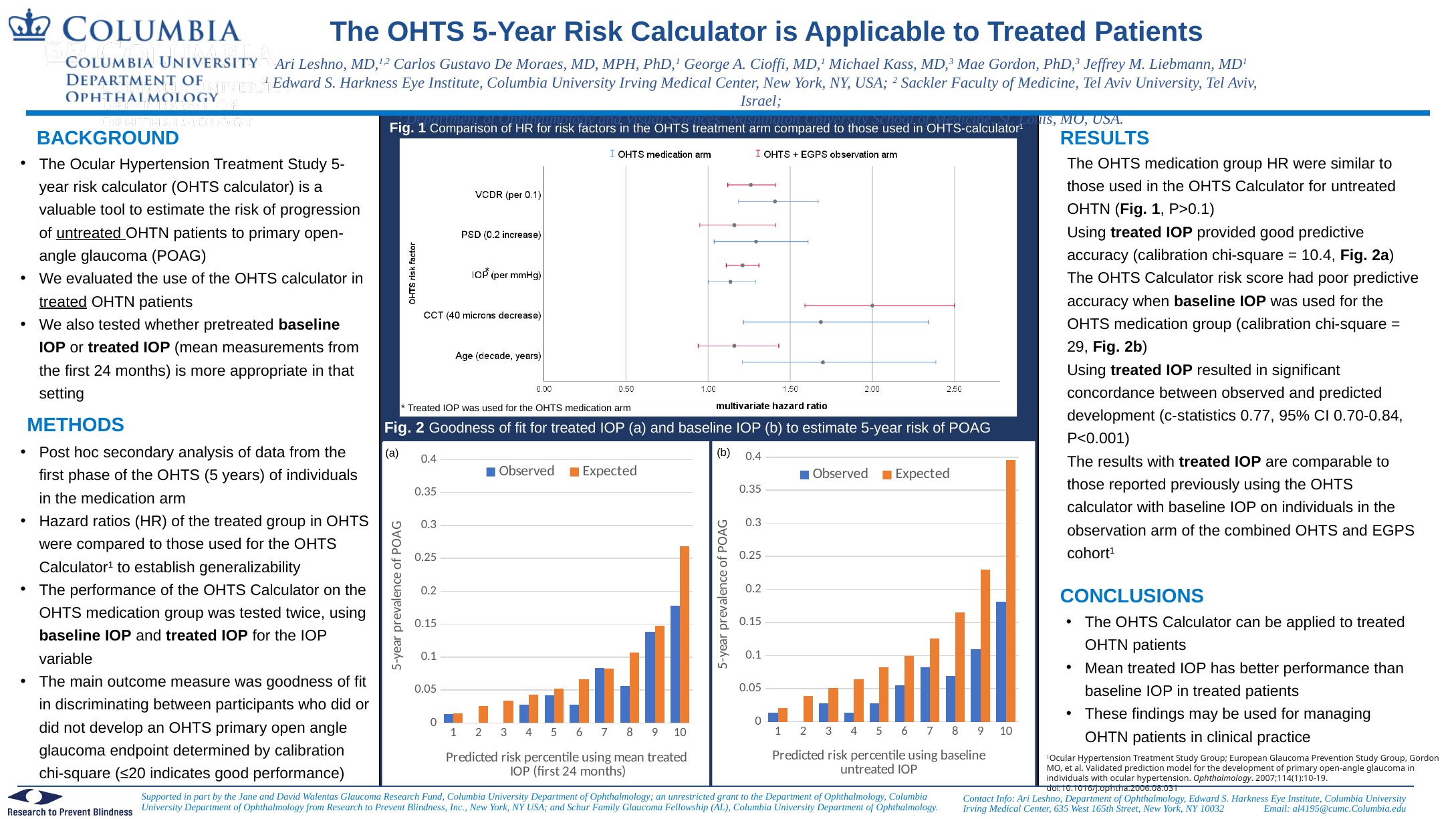
In Fig. 2a, is the Observed value for percentile 10 greater or less than 0.2? less In Fig. 2a, do the Expected values rise or fall as the predicted risk percentile increases from 1 to 10? rise In Fig. 2b, at percentile 10, which is larger, the Observed or the Expected value? Expected In Fig. 2a, how many series does the legend list? 2 In Fig. 1, how many series does the legend list? 2 In Fig. 1, what is the label of the x axis? multivariate hazard ratio In Fig. 2b, is the Expected value for percentile 10 greater or less than 0.35? greater In Fig. 2b, is the Expected value for percentile 9 greater or less than 0.2? greater In Fig. 2b, which predicted risk percentile has the lowest Observed 5-year prevalence of POAG? 2 In Fig. 2a, which predicted risk percentile has the highest Expected 5-year prevalence of POAG? 10 In Fig. 2a, how many predicted risk percentile categories are shown on the x axis? 10 What kind of chart is Fig. 2b? Bar chart